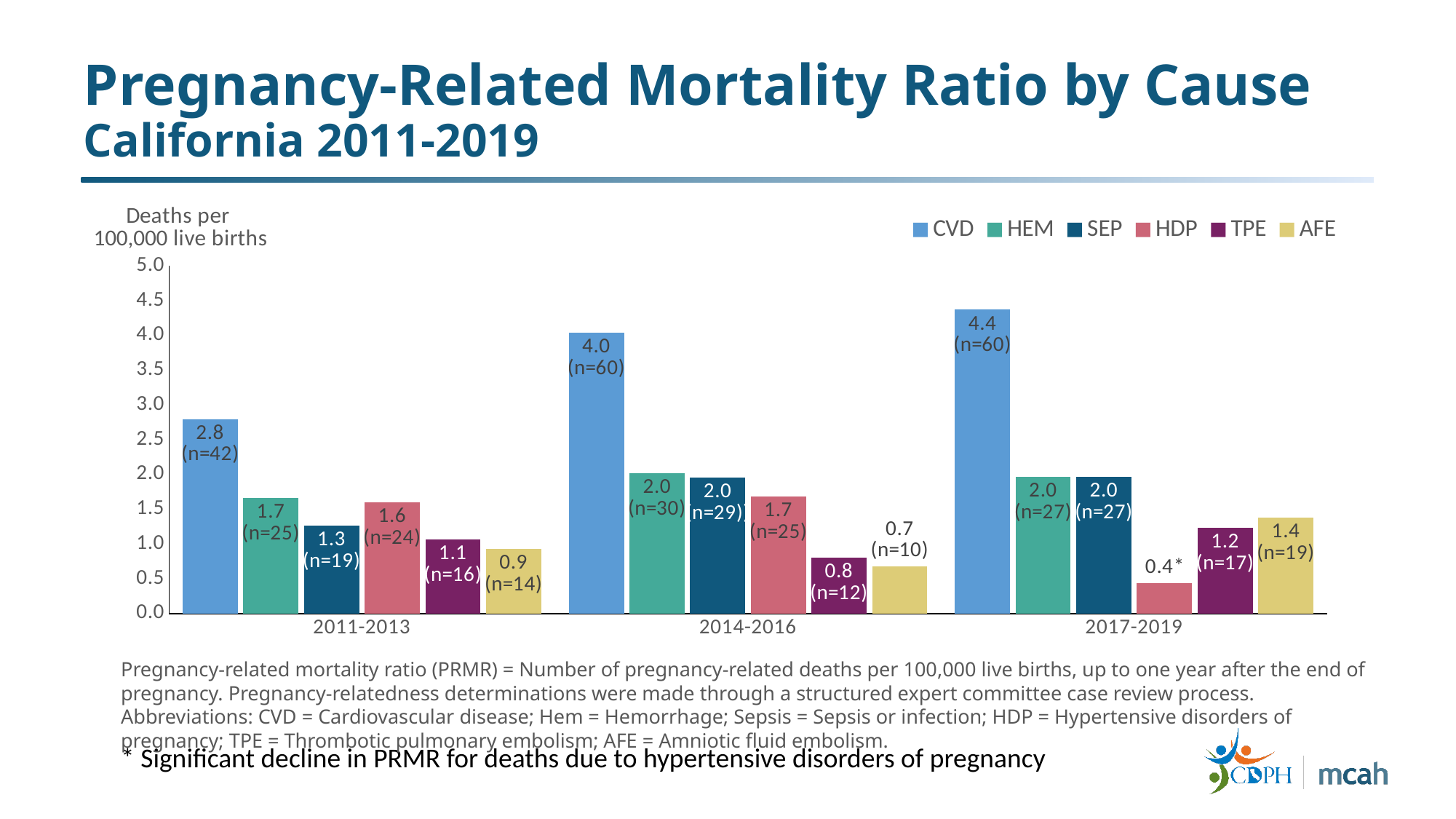
How many series does the legend list? 6 How many time periods are shown on the x axis? 3 Which cause has the highest mortality ratio in 2014-2016? CVD What is the difference between the CVD value in 2017-2019 and the CVD value in 2011-2013? 1.6 Is the value for CVD in 2014-2016 greater or less than 3.0? greater Which cause has the lowest mortality ratio in 2017-2019? HDP Does the CVD value rise or fall across the three time periods? Rise What is the value for HDP in 2011-2013? 1.6 What kind of chart is shown on the slide? Bar chart What is the value for AFE in 2014-2016? 0.7 Which is larger, the TPE value in 2011-2013 or the TPE value in 2017-2019? 2017-2019 What is the pregnancy-related mortality ratio for CVD in 2017-2019? 4.4